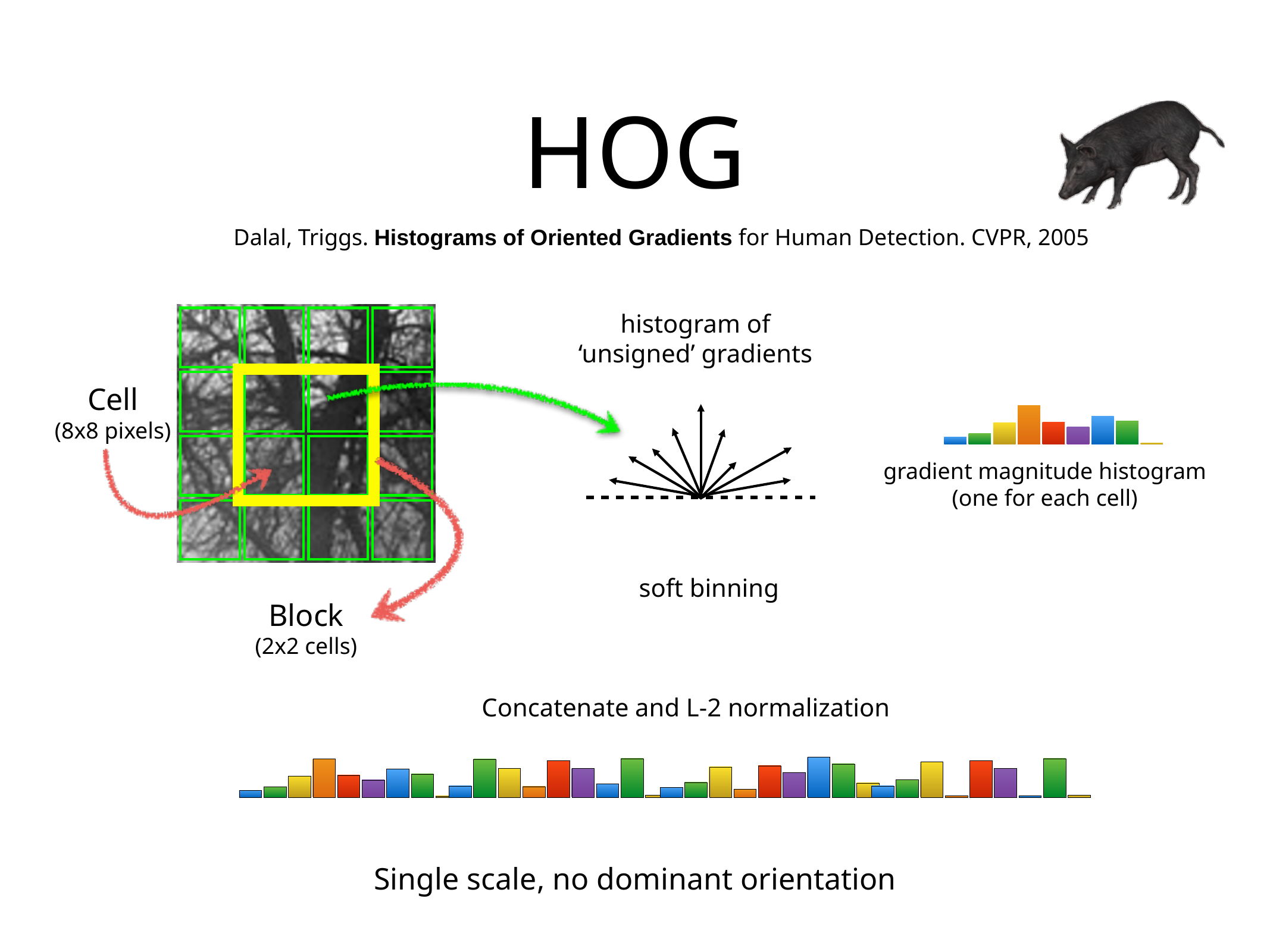
How many bars does the gradient magnitude histogram (one for each cell) contain? 9 What caption is written under the small histogram on the right? gradient magnitude histogram (one for each cell) In the gradient magnitude histogram, which bar is the tallest? the orange bar (fourth from the left) In the gradient magnitude histogram, is the orange bar taller or shorter than the first blue bar? taller What kind of chart is shown at the bottom of the slide under 'Concatenate and L-2 normalization'? bar chart In the gradient magnitude histogram, which bar is the shortest? the yellow bar at the far right What kind of chart is the gradient magnitude histogram on the right of the slide? bar chart What label appears above the long bar chart at the bottom of the slide? Concatenate and L-2 normalization